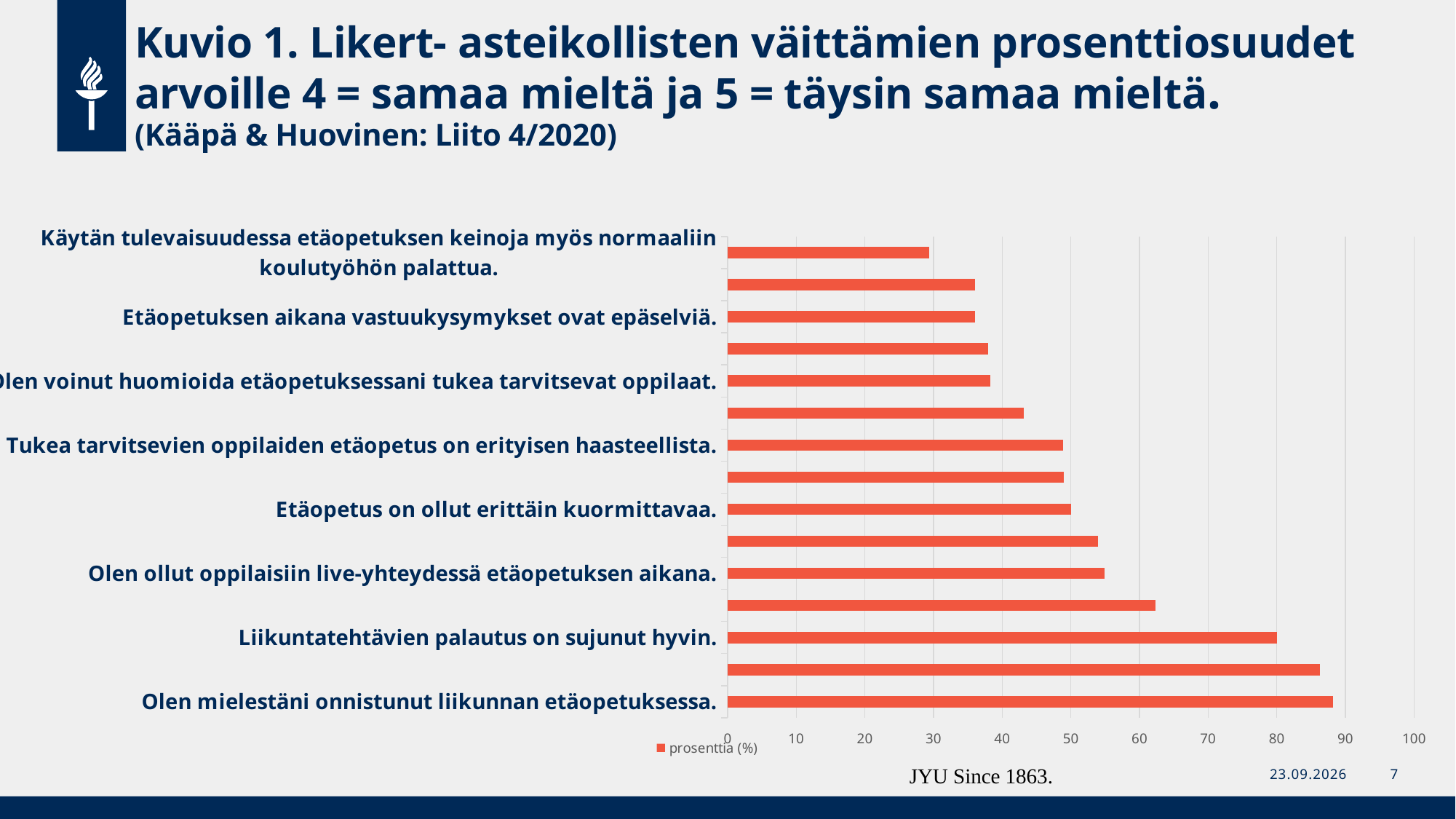
What kind of chart is shown on the slide? bar chart Which labelled statement has the highest value in the chart? Olen mielestäni onnistunut liikunnan etäopetuksessa. What is the legend entry for the series in the chart? prosenttia (%) Which has the larger value: "Olen ollut oppilaisiin live-yhteydessä etäopetuksen aikana." or "Etäopetuksen aikana vastuukysymykset ovat epäselviä."? Olen ollut oppilaisiin live-yhteydessä etäopetuksen aikana. Which has the larger value: "Liikuntatehtävien palautus on sujunut hyvin." or "Etäopetus on ollut erittäin kuormittavaa."? Liikuntatehtävien palautus on sujunut hyvin. Is the value for "Liikuntatehtävien palautus on sujunut hyvin." greater or less than 70? greater How many series does the legend list? 1 How many bars are plotted in the chart? 15 Is the value for "Etäopetus on ollut erittäin kuormittavaa." greater or less than 60? less Is the value for "Olen mielestäni onnistunut liikunnan etäopetuksessa." greater or less than 80? greater Which labelled statement has the lowest value in the chart? Käytän tulevaisuudessa etäopetuksen keinoja myös normaaliin koulutyöhön palattua.